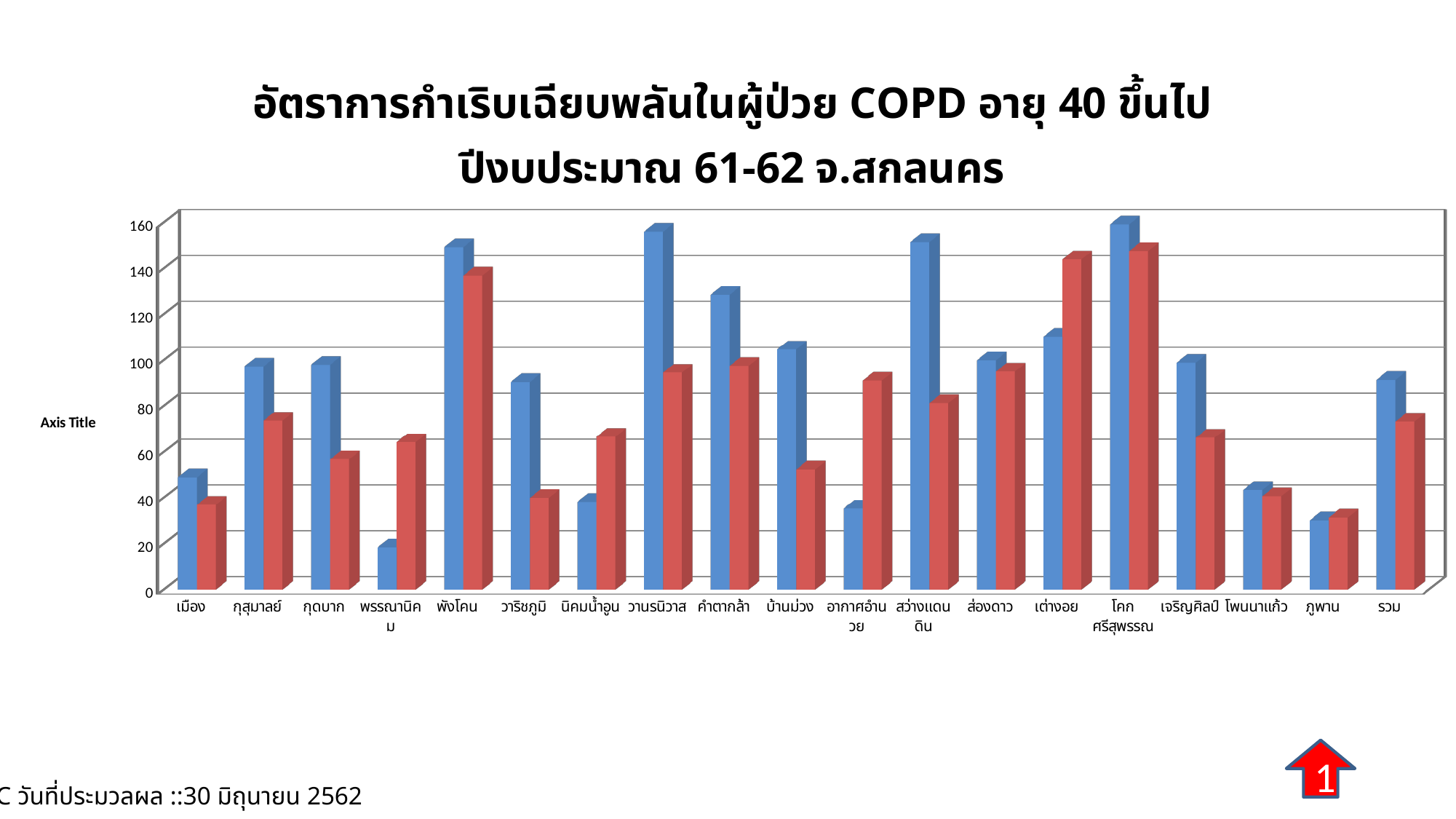
Is the red bar for บ้านม่วง greater or less than 60? less For เมือง, which bar is taller, the blue one or the red one? blue For เต่างอย, which bar is taller, the blue one or the red one? red Is the blue bar for อากาศอำนวย greater or less than 40? less Which category has the highest blue bar? โคกศรีสุพรรณ Which category has the lowest blue bar? พรรณานิคม What is the label shown on the vertical axis of the chart? Axis Title How many categories are shown along the x axis of the chart? 19 Is the blue bar for วานรนิวาส greater or less than 140? greater Which category has the lowest red bar? ภูพาน What kind of chart is shown on the slide? bar chart